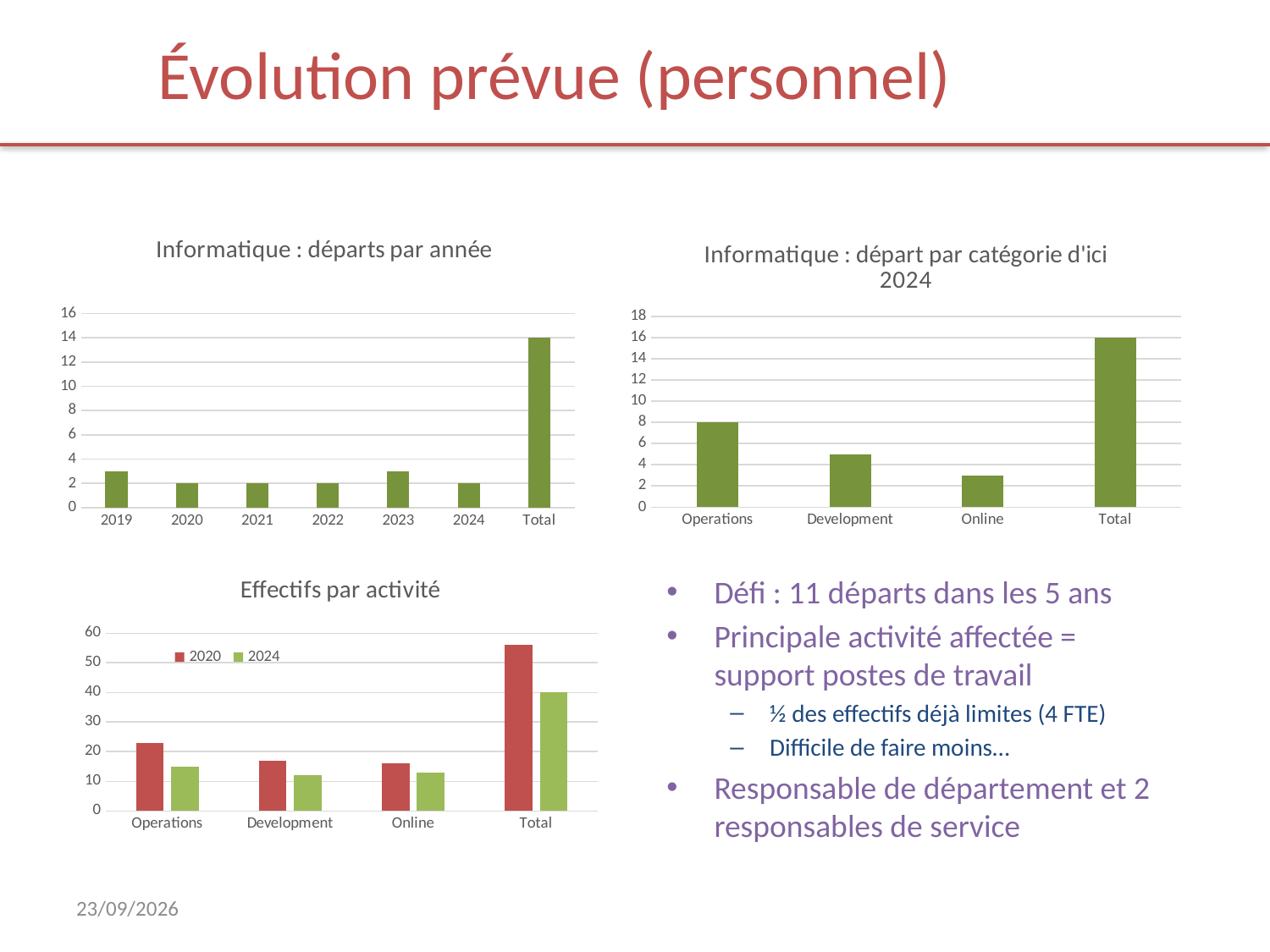
In the chart 'Informatique : départ par catégorie d'ici 2024', which category other than Total has the lowest value? Online In the chart 'Informatique : départs par année', how many categories are shown on the x axis? 7 In the chart 'Informatique : départs par année', what is the value for Total? 14 In the chart 'Informatique : départ par catégorie d'ici 2024', is the value for Development greater or less than 4? greater In the chart 'Informatique : départs par année', is the value for 2019 greater or less than 2? greater In the chart 'Effectifs par activité', what is the 2024 value for Total? 40 In the chart 'Effectifs par activité', which is larger for Operations: the 2020 value or the 2024 value? 2020 What kind of chart is 'Effectifs par activité'? bar chart In the chart 'Effectifs par activité', how many series does the legend list? 2 In the chart 'Informatique : départ par catégorie d'ici 2024', what is the value for Total? 16 In the chart 'Informatique : départ par catégorie d'ici 2024', what is the value for Operations? 8 In the chart 'Informatique : départs par année', what is the value for 2020? 2